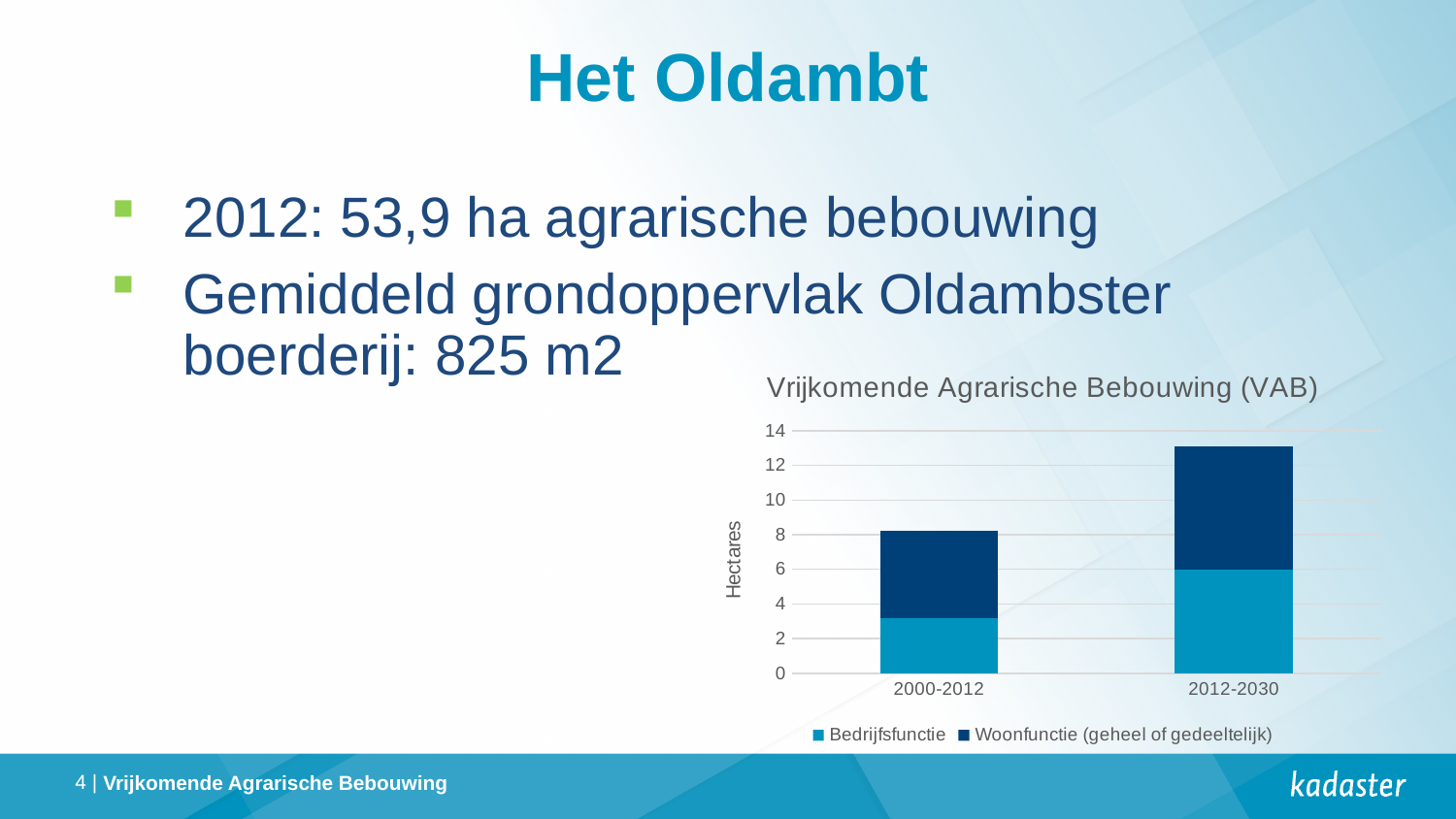
Which period has the lowest total in the chart? 2000-2012 Is the total value for 2000-2012 greater or less than 10? less Is the total value for 2012-2030 greater or less than 12? greater Is the Bedrijfsfunctie value for 2012-2030 greater or less than 4? greater Do the stacked totals rise or fall from 2000-2012 to 2012-2030? rise What is the title of the chart? Vrijkomende Agrarische Bebouwing (VAB) Which period has the taller stacked bar, 2000-2012 or 2012-2030? 2012-2030 What type of chart is shown on the slide? stacked bar chart How many categories are shown on the x axis of the chart? 2 What is the label of the y axis of the chart? Hectares How many series does the chart legend list? 2